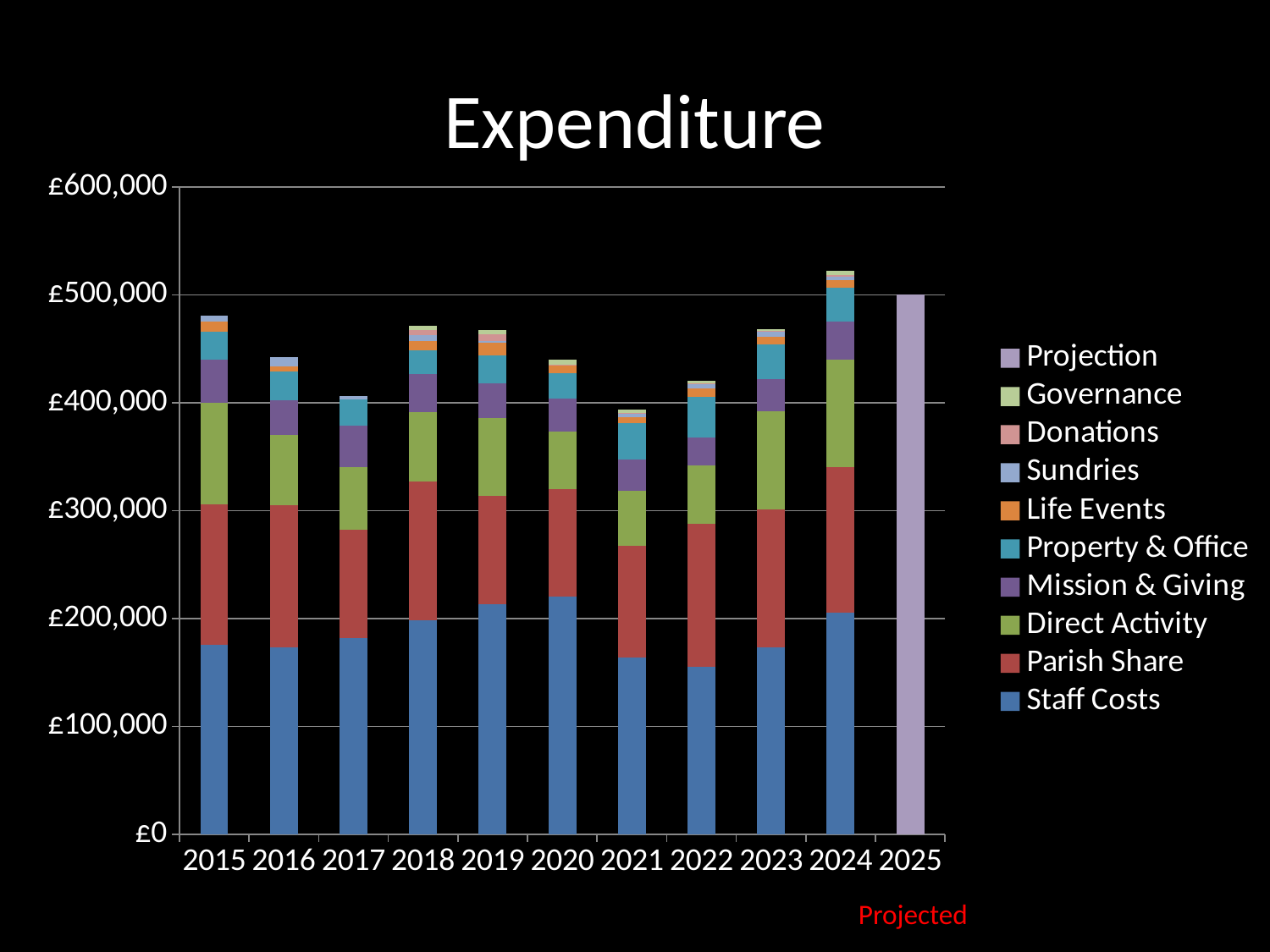
Is the total expenditure for 2024 greater or less than £500,000? greater How many series does the legend list? 10 Which year has the lowest total expenditure? 2021 How many years are shown along the x axis of the chart? 11 Does total expenditure rise or fall from 2021 to 2024? rise What is the projected expenditure for 2025? £500,000 What type of chart is shown on the slide? Stacked bar chart Is the Staff Costs value for 2022 greater or less than £200,000? less What is the title of the chart? Expenditure Which year has the larger Staff Costs segment, 2019 or 2022? 2019 Which year from 2015 to 2024 has the highest total expenditure? 2024 Is the total expenditure for 2021 greater or less than £400,000? less